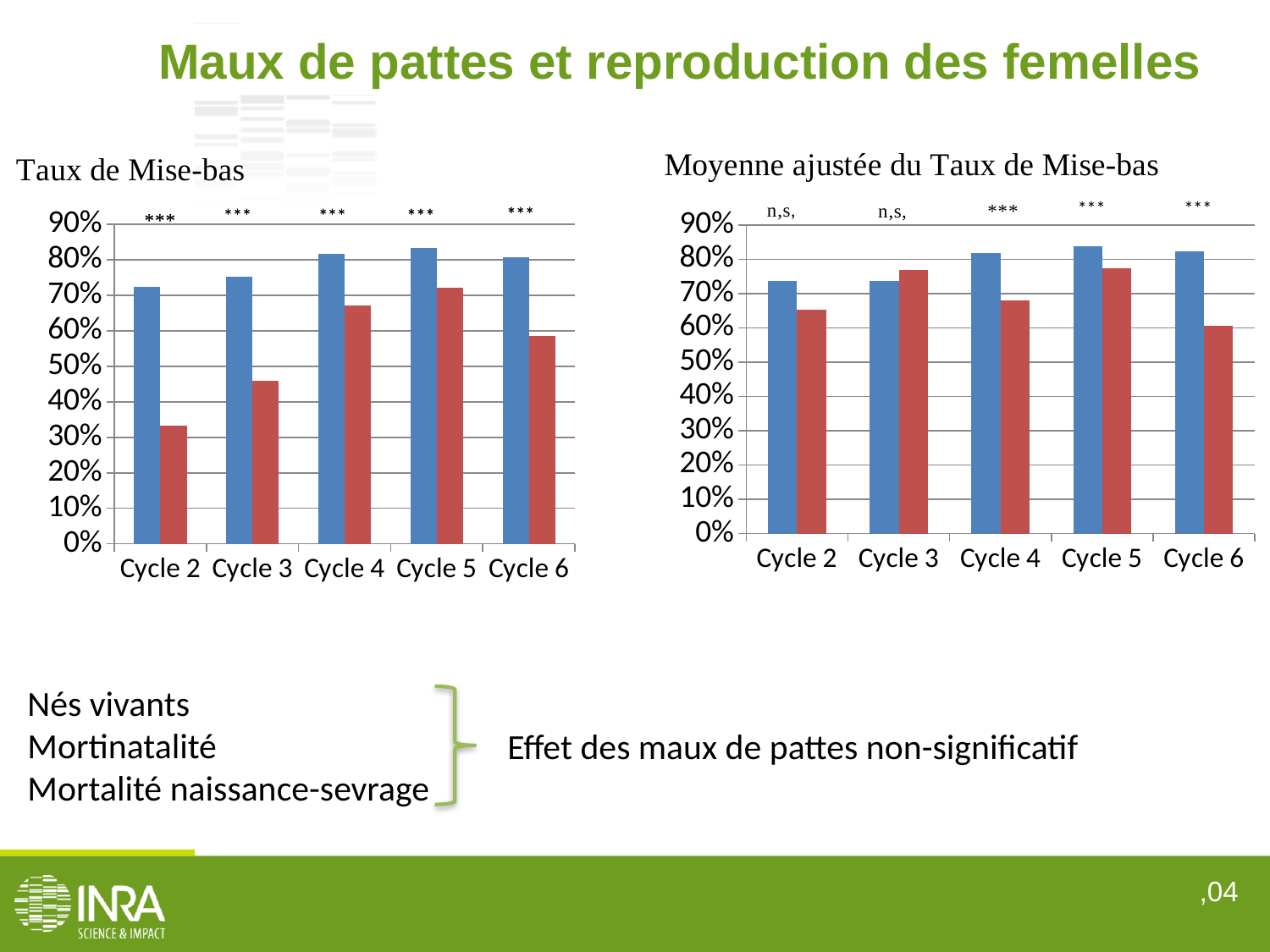
What kind of chart is the 'Taux de Mise-bas' chart on the left? bar chart What is the highest value shown on the y axis of the 'Taux de Mise-bas' chart? 90% In the 'Moyenne ajustée du Taux de Mise-bas' chart, which cycle has the lowest red bar? Cycle 6 In the 'Moyenne ajustée du Taux de Mise-bas' chart, which is larger for Cycle 3, the blue bar or the red bar? the red bar How many cycle categories are shown on the x axis of the 'Taux de Mise-bas' chart? 5 What is the title of the chart on the right of the slide? Moyenne ajustée du Taux de Mise-bas In the 'Taux de Mise-bas' chart, is the red bar for Cycle 3 greater or less than 50%? less In the 'Taux de Mise-bas' chart, which cycle has the lowest red bar? Cycle 2 In the 'Taux de Mise-bas' chart, is the blue bar for Cycle 4 greater or less than 80%? greater In the 'Taux de Mise-bas' chart, is the red bar for Cycle 2 greater or less than 40%? less In the 'Taux de Mise-bas' chart, which is larger for Cycle 2, the blue bar or the red bar? the blue bar